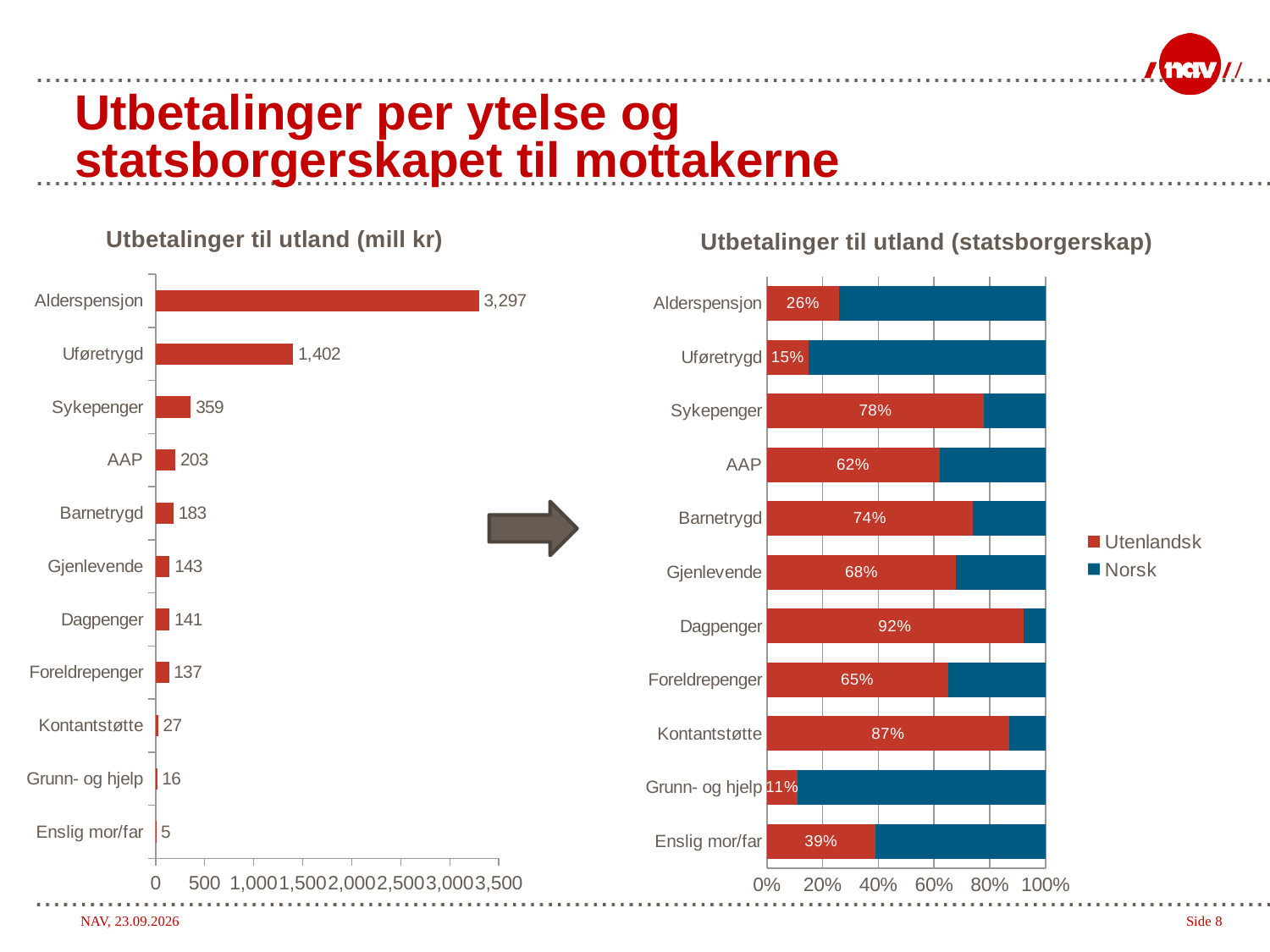
In the chart titled "Utbetalinger til utland (statsborgerskap)", how many series does the legend list? 2 In the chart titled "Utbetalinger til utland (mill kr)", how many categories are shown? 11 In the chart titled "Utbetalinger til utland (mill kr)", which is larger, Sykepenger or AAP? Sykepenger In the chart titled "Utbetalinger til utland (statsborgerskap)", which category has the highest Utenlandsk share? Dagpenger In the chart titled "Utbetalinger til utland (mill kr)", what is the difference between Alderspensjon and Uføretrygd? 1,895 In the chart titled "Utbetalinger til utland (mill kr)", which category has the lowest value? Enslig mor/far In the chart titled "Utbetalinger til utland (statsborgerskap)", what is the difference between the Utenlandsk shares for Kontantstøtte and Foreldrepenger? 22% In the chart titled "Utbetalinger til utland (mill kr)", what is the value for Barnetrygd? 183 In the chart titled "Utbetalinger til utland (statsborgerskap)", what is the Utenlandsk share for Grunn- og hjelp? 11% What kind of chart is "Utbetalinger til utland (mill kr)"? Bar chart In the chart titled "Utbetalinger til utland (statsborgerskap)", what is the Utenlandsk share for Dagpenger? 92% In the chart titled "Utbetalinger til utland (mill kr)", what is the value for Alderspensjon? 3,297